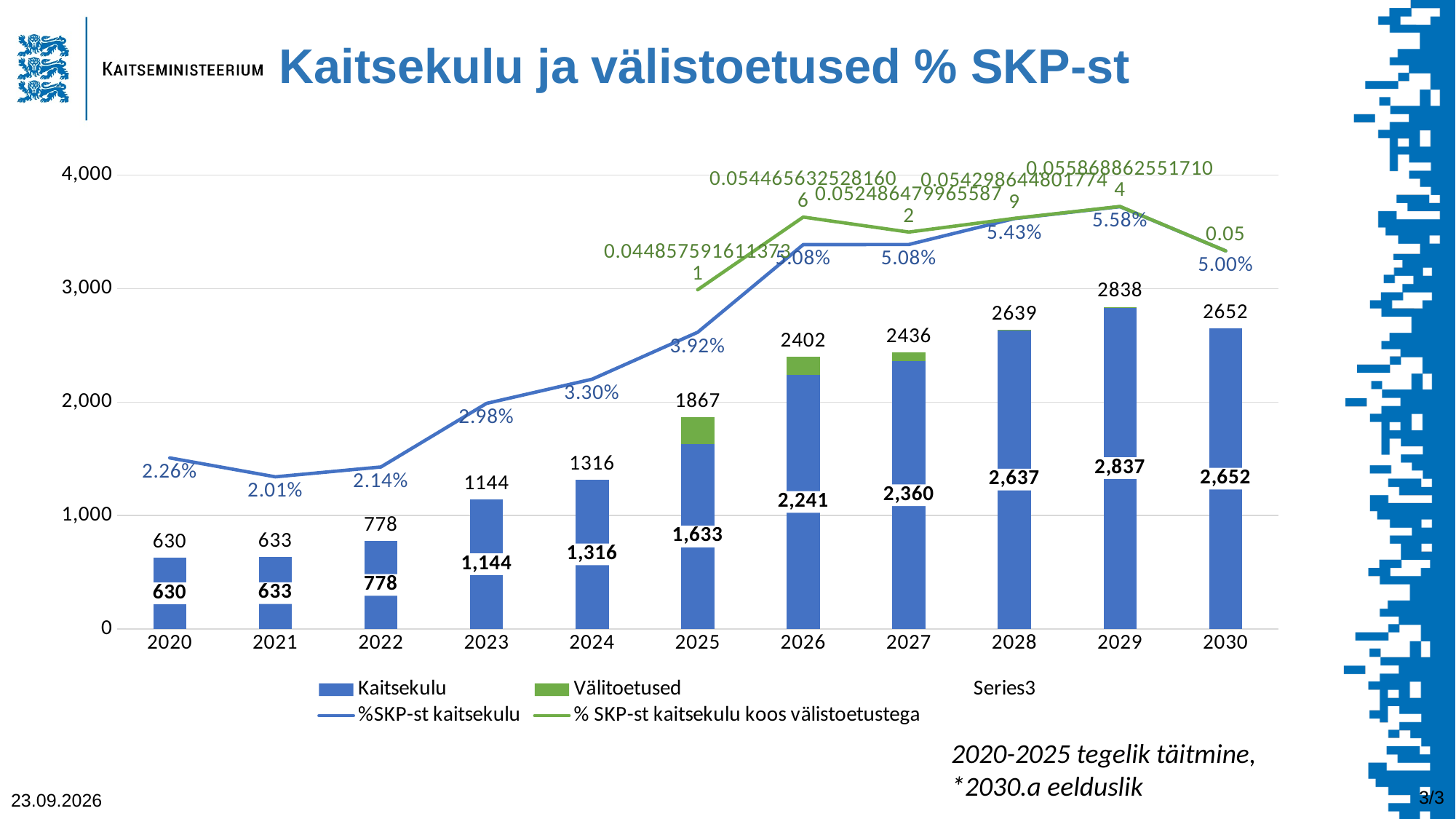
What is the Välitoetused value for 2025, given the total 1867 and Kaitsekulu 1,633? 234 How many series does the legend list? 5 In which year is the Kaitsekulu value highest? 2029 What is the %SKP-st kaitsekulu value for 2025? 3.92% In which year is the %SKP-st kaitsekulu value lowest? 2021 Does the %SKP-st kaitsekulu line rise or fall from 2022 to 2029? rise What is the Kaitsekulu value for 2029? 2,837 What is the total value labelled above the bar for 2026? 2402 What is the difference between the Kaitsekulu values for 2028 and 2027? 277 How many years are shown on the x axis? 11 Is the total bar value for 2025 greater or less than 2,000? less Which year has the larger Kaitsekulu value, 2029 or 2030? 2029